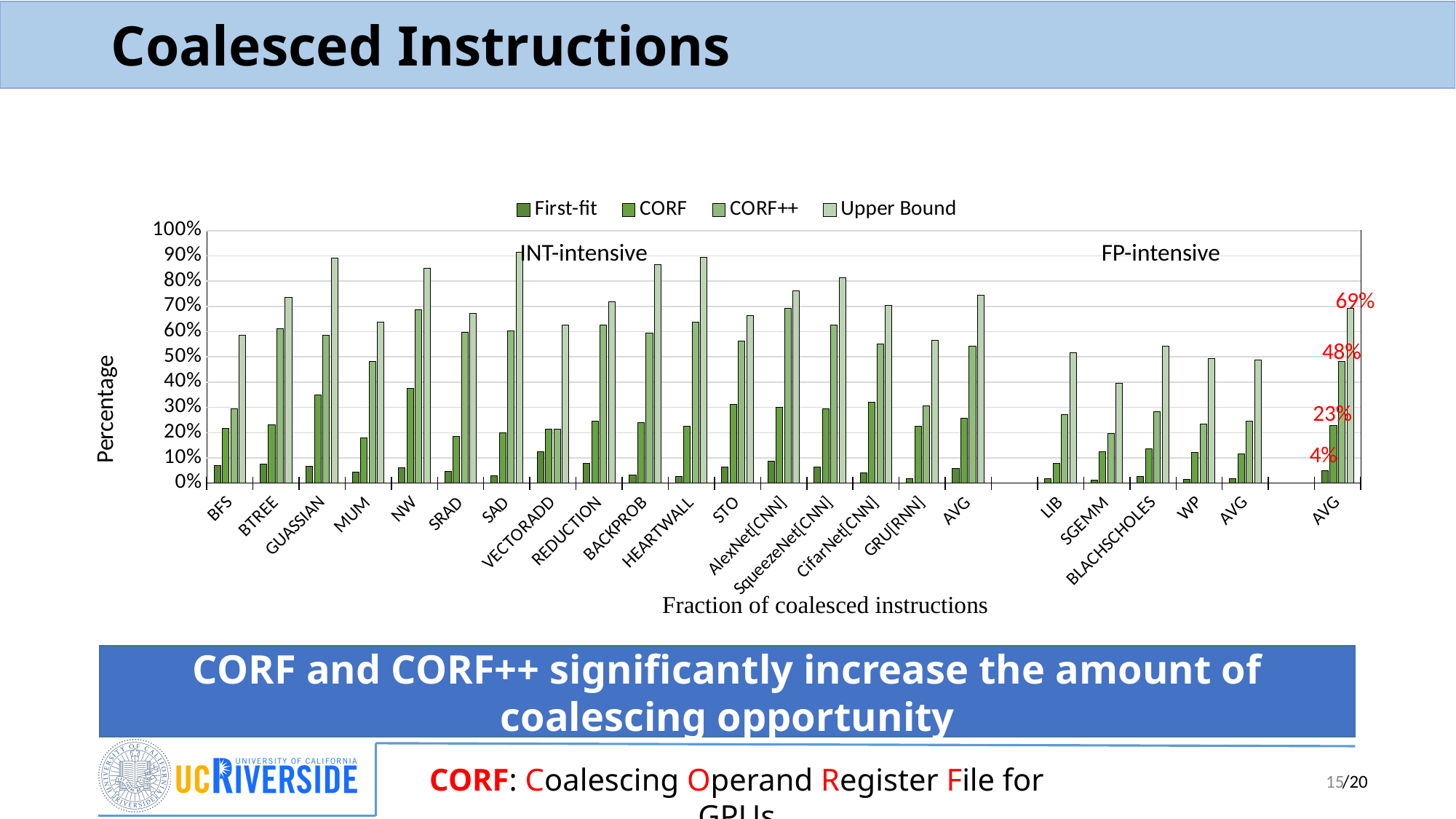
What is the label on the y axis of the chart? Percentage Is the Upper Bound value for GUASSIAN greater or less than 80%? greater What is the First-fit value for the final AVG group on the far right of the chart? 4% Which has the larger Upper Bound value, BFS or BTREE? BTREE What is the CORF++ value for the final AVG group on the far right of the chart? 48% Which category has the lowest Upper Bound value? SGEMM For the final AVG group on the far right, what is the difference between the Upper Bound value and the CORF++ value? 21% How many series does the chart legend list? 4 What is the Upper Bound value for the final AVG group on the far right of the chart? 69% What are the four series listed in the chart legend? First-fit, CORF, CORF++, Upper Bound What kind of chart is shown on the slide? bar chart What is the CORF value for the final AVG group on the far right of the chart? 23%